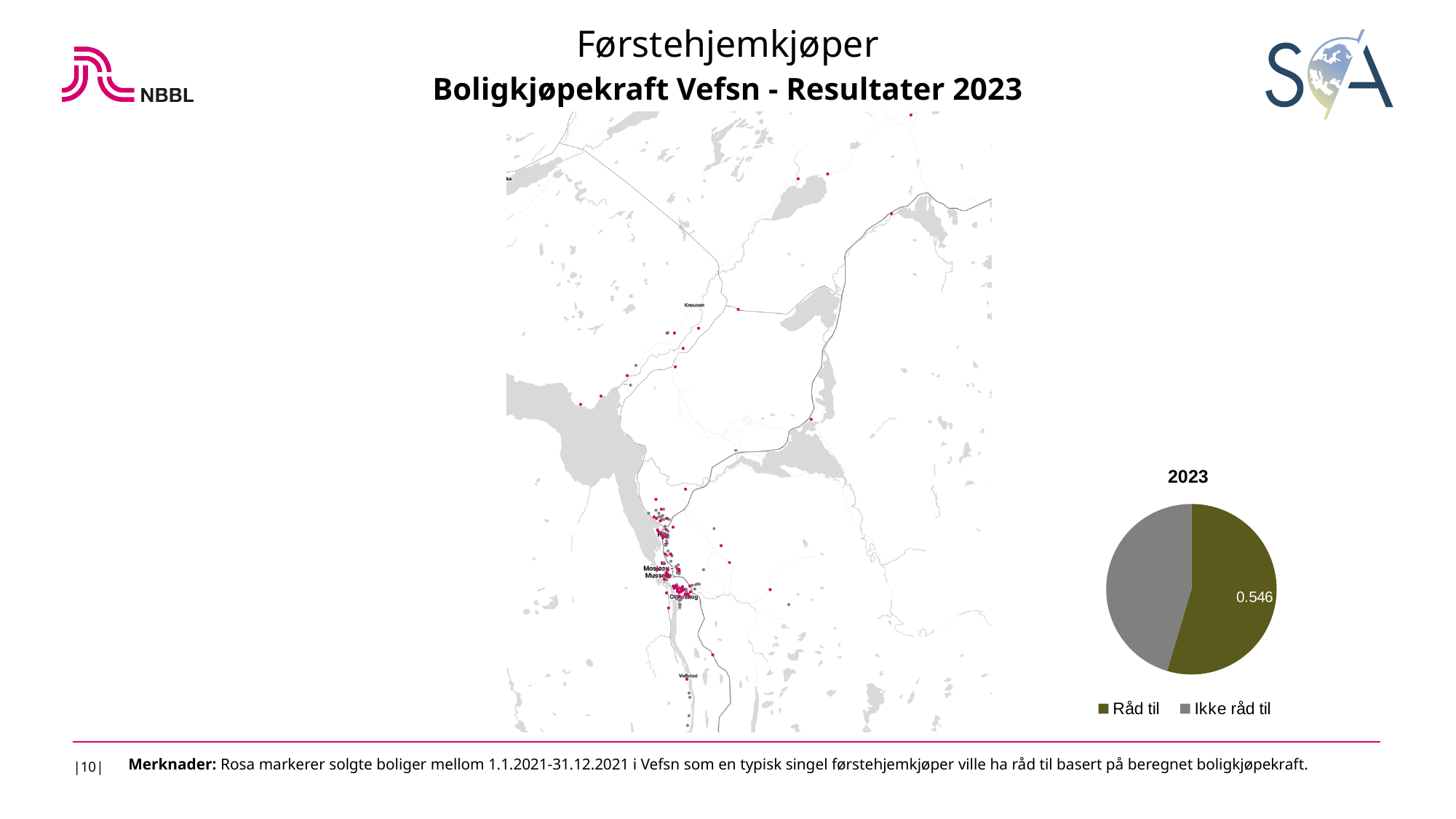
What is the title of the pie chart? 2023 Which is larger in the pie chart, "Råd til" or "Ikke råd til"? Råd til Which slice of the pie chart is the smallest? Ikke råd til What colour is the "Ikke råd til" slice in the pie chart? Grey How many entries does the pie chart's legend list? 2 Which slice of the pie chart is the largest? Råd til What kind of chart is shown on the right side of the slide? Pie chart How many slices does the pie chart have? 2 What value is printed on the "Råd til" slice of the pie chart? 0.546